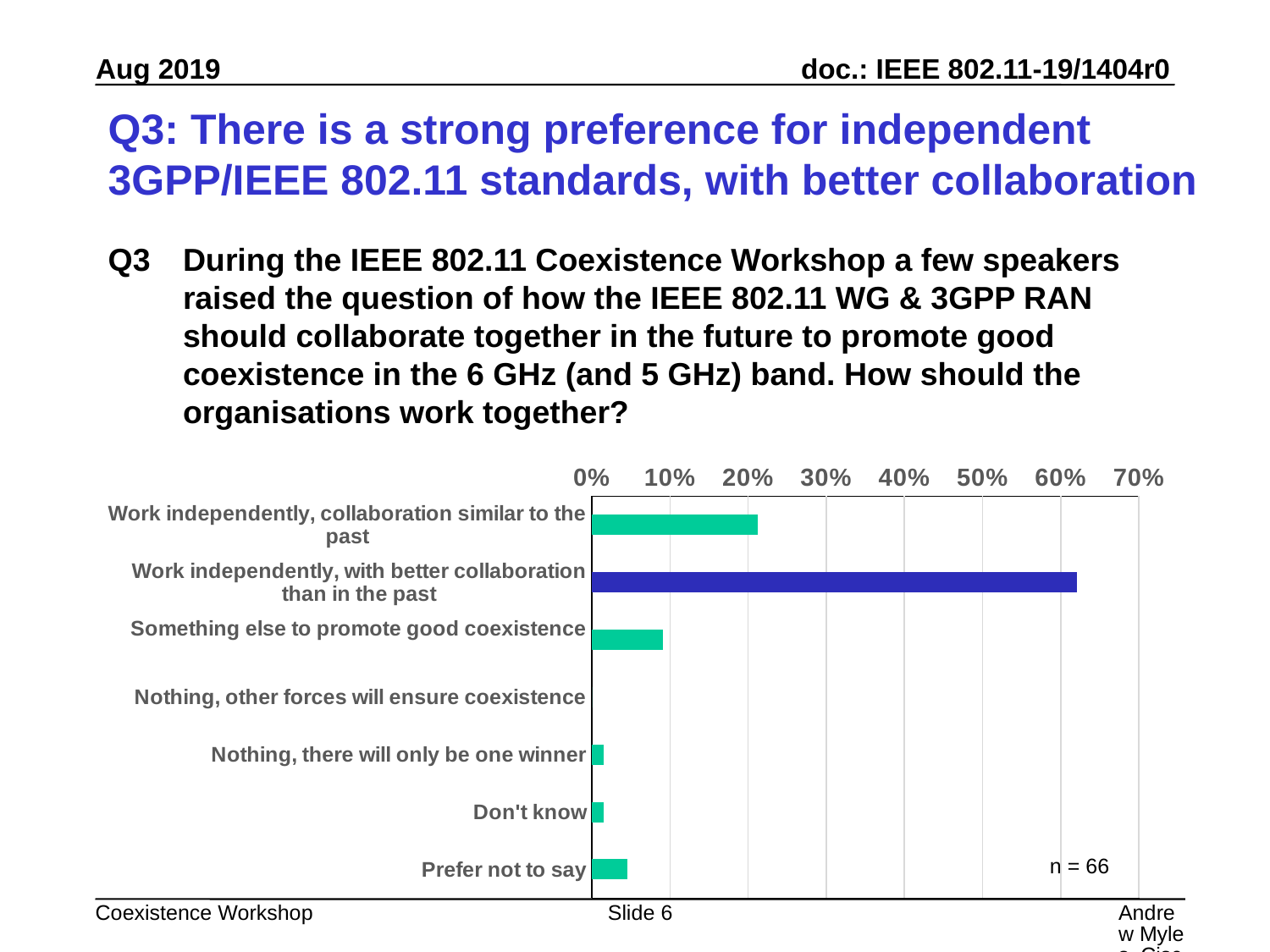
How many response categories are shown in the chart? 7 What sample size (n) is noted on the chart? n = 66 Which response category has the lowest value in the chart? Nothing, other forces will ensure coexistence What kind of chart is shown on the slide? bar chart Is the value for 'Work independently, collaboration similar to the past' greater or less than 30%? less Which response category has the highest value in the chart? Work independently, with better collaboration than in the past Which is larger: the value for 'Work independently, collaboration similar to the past' or the value for 'Something else to promote good coexistence'? Work independently, collaboration similar to the past What is the highest value shown on the percentage axis of the chart? 70% Which is larger: the value for 'Prefer not to say' or the value for 'Don't know'? Prefer not to say Is the value for 'Work independently, with better collaboration than in the past' greater or less than 60%? greater Is the value for 'Prefer not to say' greater or less than 10%? less